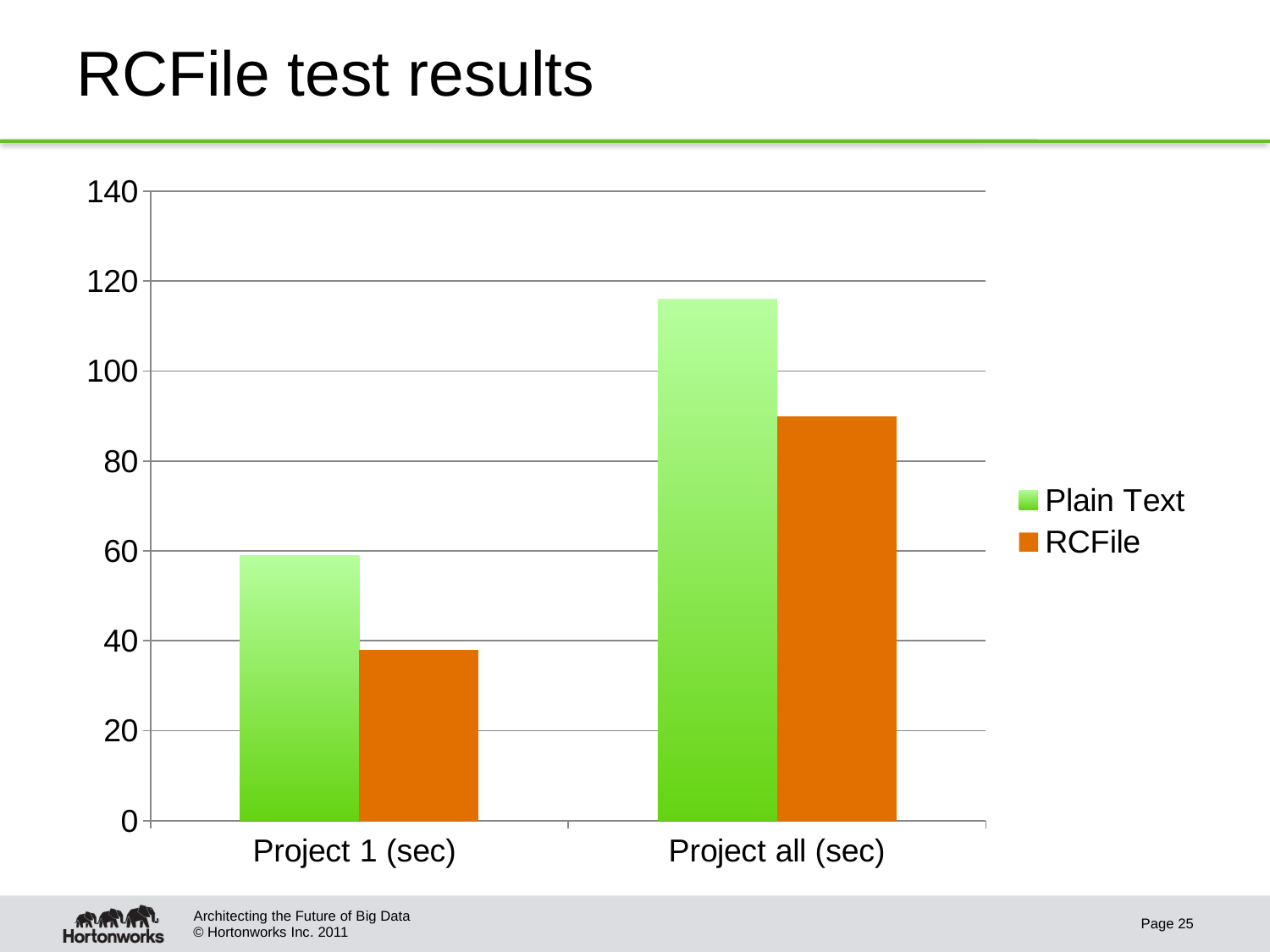
What kind of chart is shown on the slide? bar chart How many categories are shown on the x axis? 2 Is the RCFile value for Project 1 (sec) greater or less than 60? less Which series has the tallest bar in the chart? Plain Text For Project all (sec), which is larger: Plain Text or RCFile? Plain Text Which bar is the lowest in the chart? RCFile for Project 1 (sec) For Project 1 (sec), which is larger: Plain Text or RCFile? Plain Text How many series does the legend list? 2 Is the Plain Text value for Project 1 (sec) greater or less than 40? greater What is the title of the slide containing the chart? RCFile test results Is the Plain Text value for Project all (sec) greater or less than 100? greater